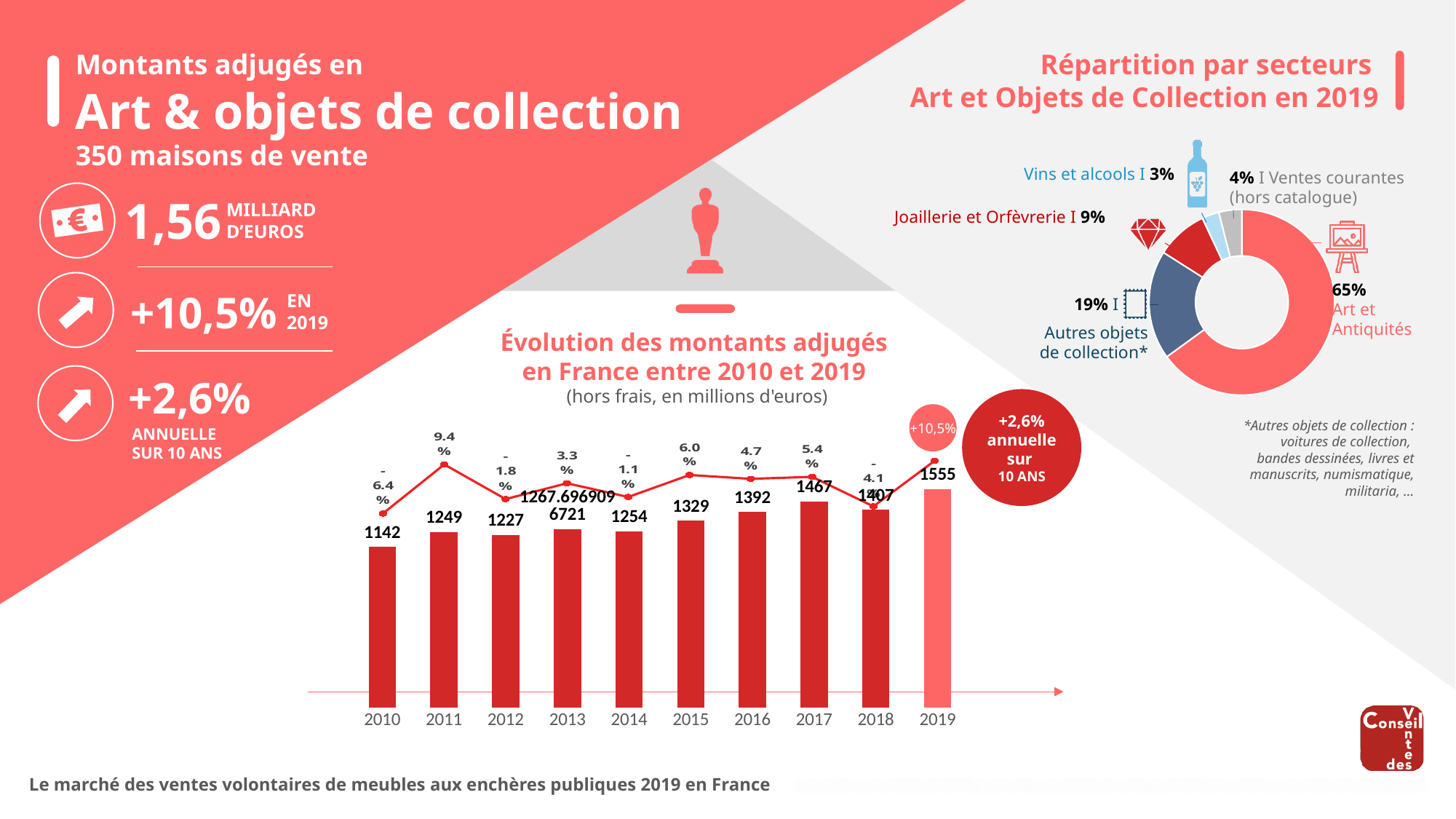
In the chart 'Répartition par secteurs Art et Objets de Collection en 2019', what share does 'Art et Antiquités' have? 65% In the chart 'Répartition par secteurs Art et Objets de Collection en 2019', which sector has the smallest share? Vins et alcools In the chart 'Évolution des montants adjugés en France entre 2010 et 2019', what is the difference between the 2019 value and the 2010 value? 413 In the chart 'Évolution des montants adjugés en France entre 2010 et 2019', which year has the larger value, 2017 or 2018? 2017 In the chart 'Évolution des montants adjugés en France entre 2010 et 2019', what percentage change is shown on the line for 2011? 9.4% In the chart 'Évolution des montants adjugés en France entre 2010 et 2019', which year has the lowest value? 2010 In the chart 'Répartition par secteurs Art et Objets de Collection en 2019', what share does 'Joaillerie et Orfèvrerie' have? 9% What kind of chart is 'Évolution des montants adjugés en France entre 2010 et 2019'? Bar chart with a line In the chart 'Évolution des montants adjugés en France entre 2010 et 2019', how many years are shown on the x axis? 10 In the chart 'Évolution des montants adjugés en France entre 2010 et 2019', what is the value for 2019? 1555 In the chart 'Évolution des montants adjugés en France entre 2010 et 2019', what is the value for 2016? 1392 In the chart 'Évolution des montants adjugés en France entre 2010 et 2019', which year has the highest value? 2019